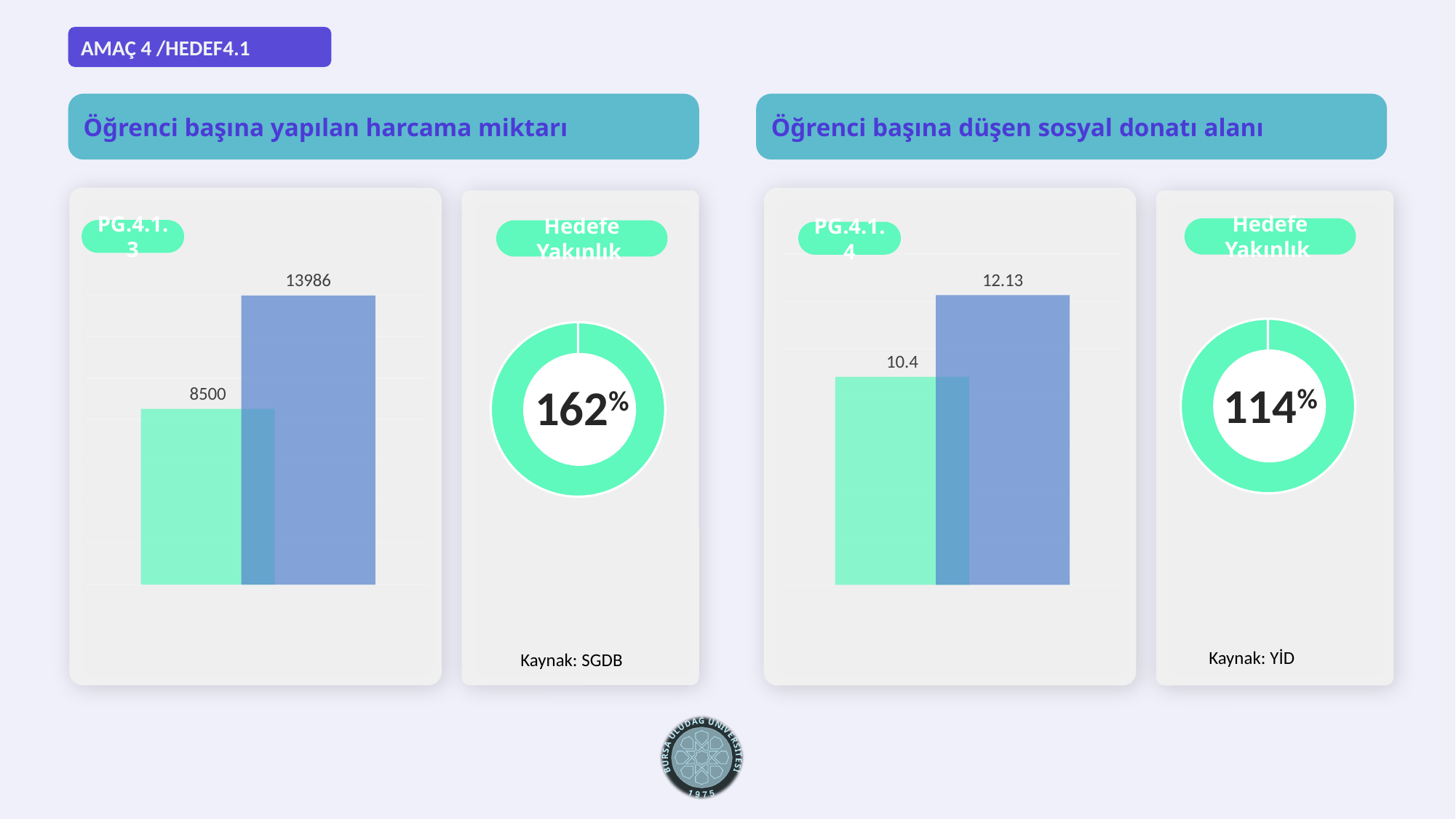
What source is cited below the 'Hedefe Yakınlık' donut chart on the right side of the slide? Kaynak: YİD In the 'Öğrenci başına yapılan harcama miktarı' bar chart, what is the difference between the two labelled bar values? 5486 How many bars are plotted in the 'Öğrenci başına düşen sosyal donatı alanı' bar chart? 2 What percentage is shown in the 'Hedefe Yakınlık' donut chart next to the 'Öğrenci başına yapılan harcama miktarı' chart? 162% What percentage is shown in the 'Hedefe Yakınlık' donut chart next to the 'Öğrenci başına düşen sosyal donatı alanı' chart? 114% In the 'Öğrenci başına yapılan harcama miktarı' bar chart, what value is labelled on the green bar? 8500 In the 'Öğrenci başına düşen sosyal donatı alanı' bar chart, what value is labelled on the blue bar? 12.13 In the 'Öğrenci başına düşen sosyal donatı alanı' bar chart, what is the difference between the two labelled bar values? 1.73 In the 'Öğrenci başına düşen sosyal donatı alanı' bar chart, what value is labelled on the green bar? 10.4 In the 'Öğrenci başına yapılan harcama miktarı' bar chart, which bar is taller, the green one or the blue one? the blue one What kind of chart is used under the 'PG.4.1.3' label on the left of the slide? bar chart In the 'Öğrenci başına yapılan harcama miktarı' bar chart, what value is labelled on the taller blue bar? 13986